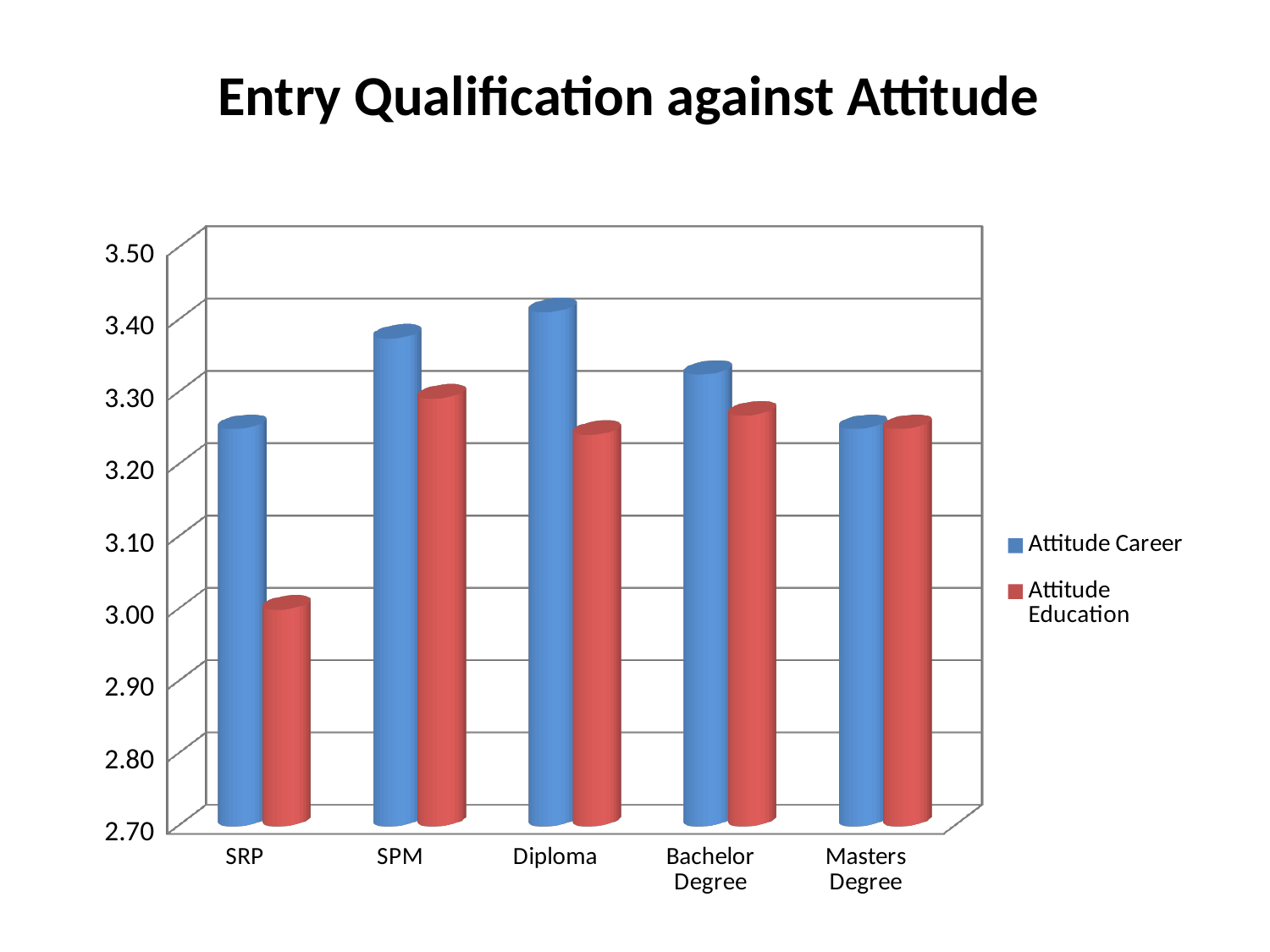
How many entry qualification categories are shown on the x axis? 5 How many series does the legend list? 2 For Diploma, which is larger: Attitude Career or Attitude Education? Attitude Career What is the title of the chart? Entry Qualification against Attitude Which category has the highest Attitude Career value? Diploma Is the Attitude Career value for SPM greater or less than 3.30? greater For SRP, which is larger: Attitude Career or Attitude Education? Attitude Career Is the Attitude Education value for SRP greater or less than 3.10? less What kind of chart is shown on the slide? bar chart Which category has the lowest Attitude Education value? SRP Which series is shown in red? Attitude Education Is the Attitude Career value for Diploma greater or less than 3.30? greater